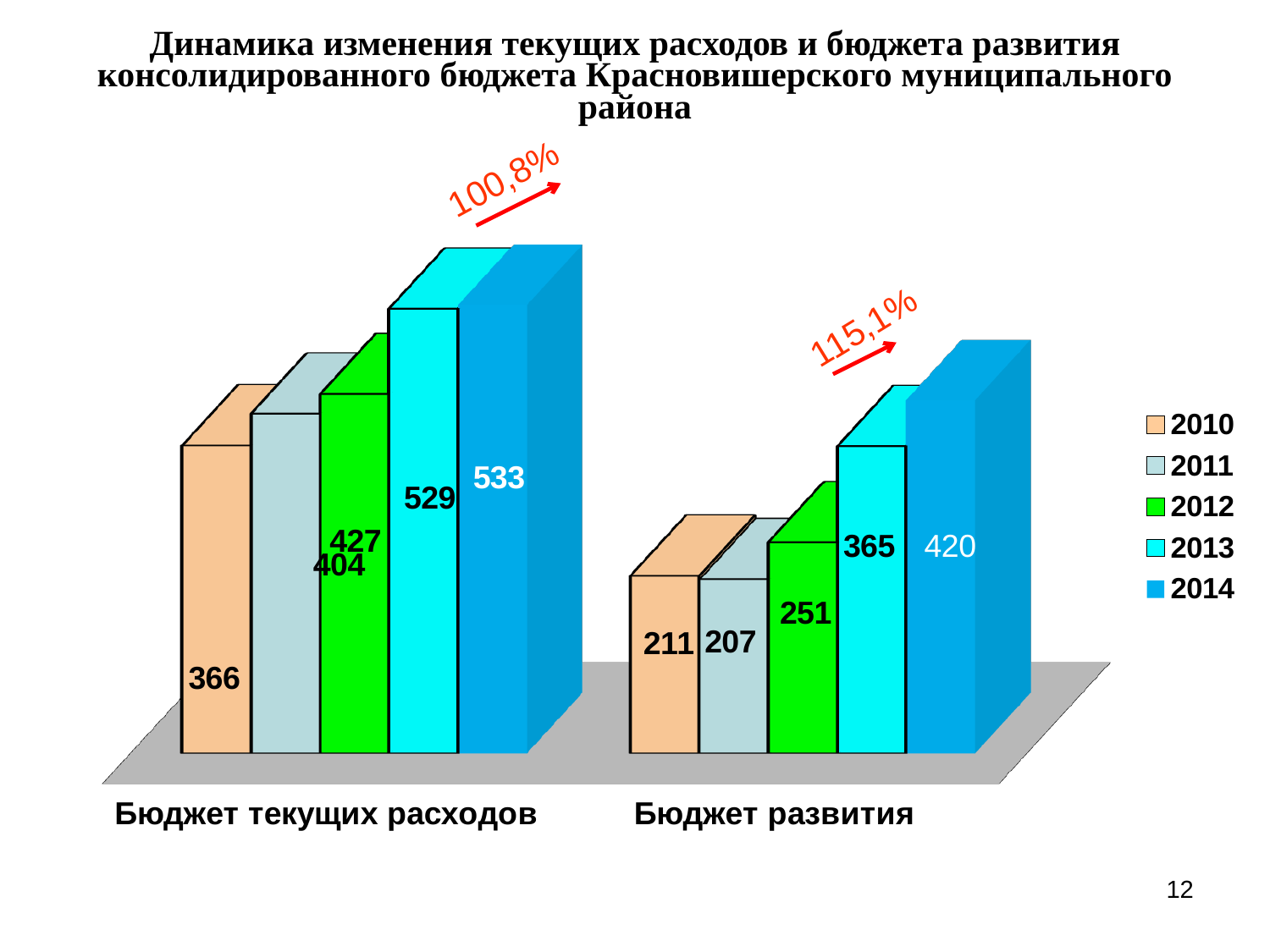
Which year has the highest value in the Бюджет развития group? 2014 Which year has the lowest value in the Бюджет развития group? 2011 What is the value for 2012 in the Бюджет развития group? 251 What is the value for 2013 in the Бюджет текущих расходов group? 529 What is the difference between the 2014 and 2013 values in the Бюджет текущих расходов group? 4 How many category groups are shown on the x axis? 2 What is the difference between the 2014 and 2010 values in the Бюджет развития group? 209 What kind of chart is shown on the slide? Bar chart What is the value for 2014 in the Бюджет развития group? 420 How many series does the legend list? 5 Which is larger: the 2013 value for Бюджет текущих расходов or the 2013 value for Бюджет развития? Бюджет текущих расходов What is the value for 2010 in the Бюджет текущих расходов group? 366